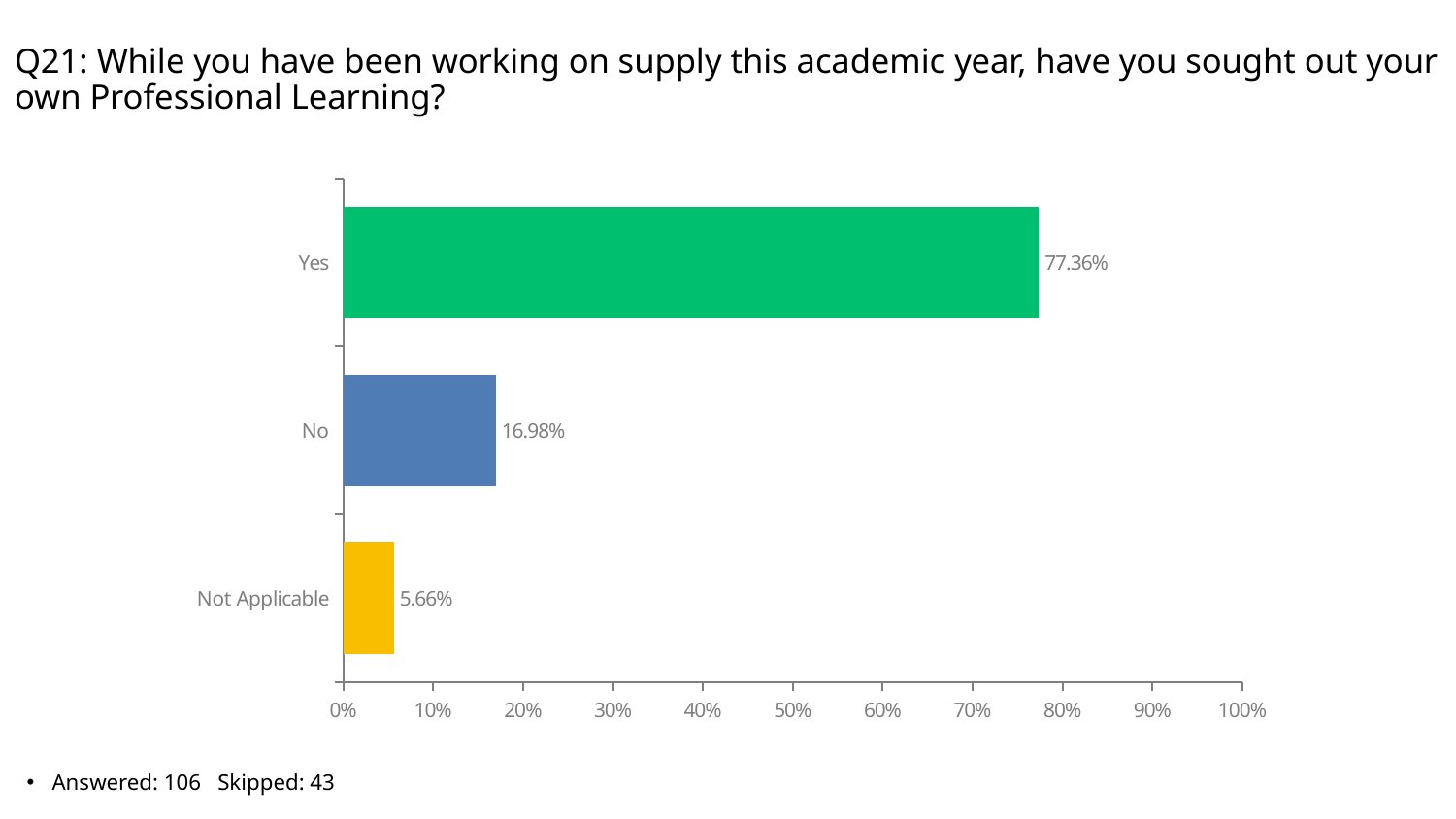
What is the difference in percentage points between the No and Not Applicable responses? 11.32 Is the value for Yes greater or less than 70%? greater What is the difference in percentage points between the Yes and No responses? 60.38 What percentage of respondents answered Yes? 77.36% Which response category has the lowest percentage? Not Applicable How many response categories are shown in the chart? 3 What colour is the bar for the Yes response? Green What percentage of respondents answered No? 16.98% What kind of chart is shown on the slide? Bar chart Which is larger, the percentage for No or for Not Applicable? No Which response category has the highest percentage? Yes What percentage of respondents answered Not Applicable? 5.66%